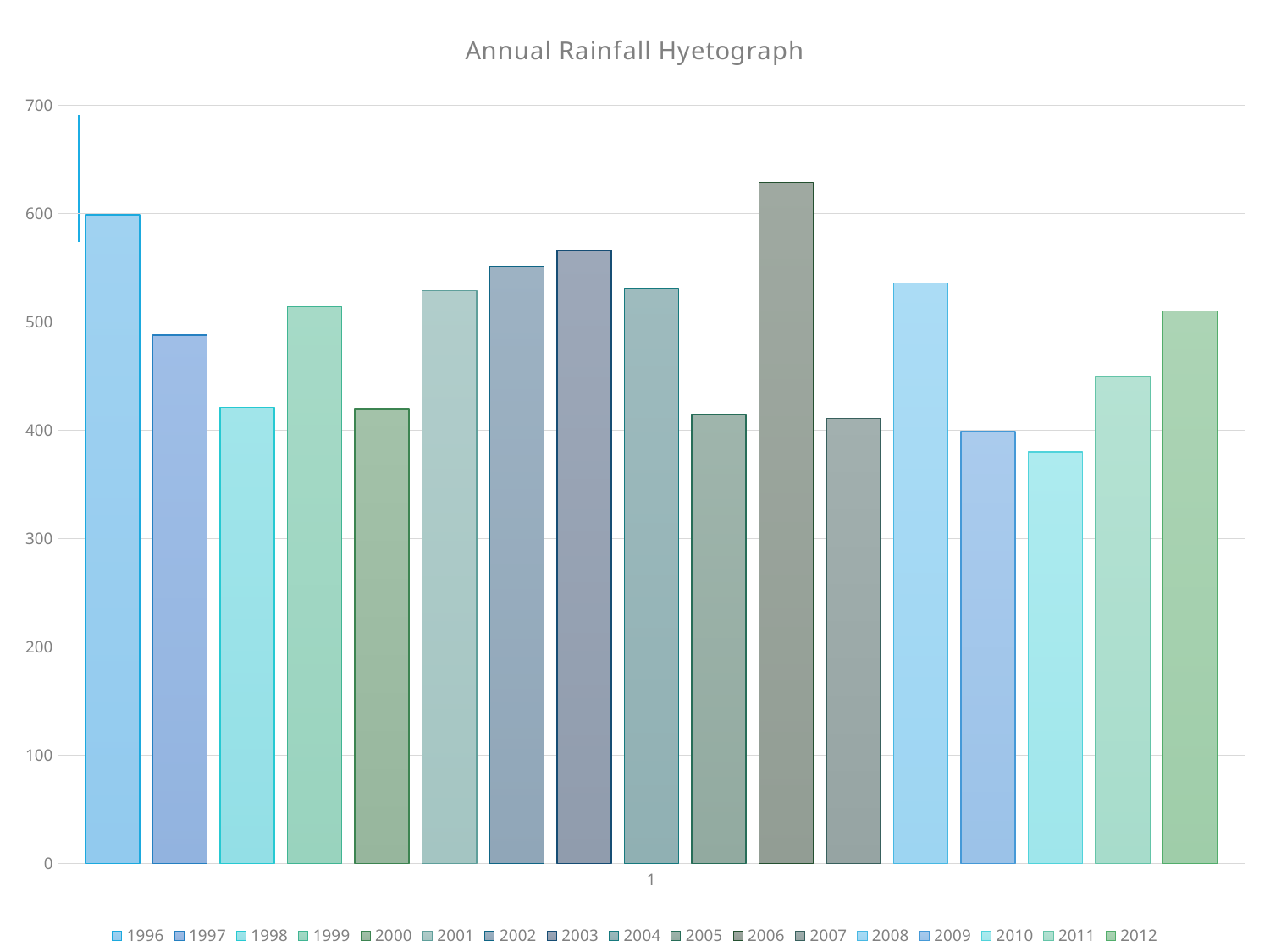
What is the title of the chart? Annual Rainfall Hyetograph Is the value for 2010 greater or less than 400? less Which year has the highest bar? 2006 Is the value for 2003 greater or less than 500? greater Is the value for 1997 greater or less than 500? less How many series does the legend list? 17 Which year has the lowest bar? 2010 Which is larger, the value for 1999 or the value for 2000? 1999 Which is larger, the value for 1996 or the value for 1997? 1996 What type of chart is shown on the slide? bar chart Which is larger, the value for 2011 or the value for 2012? 2012